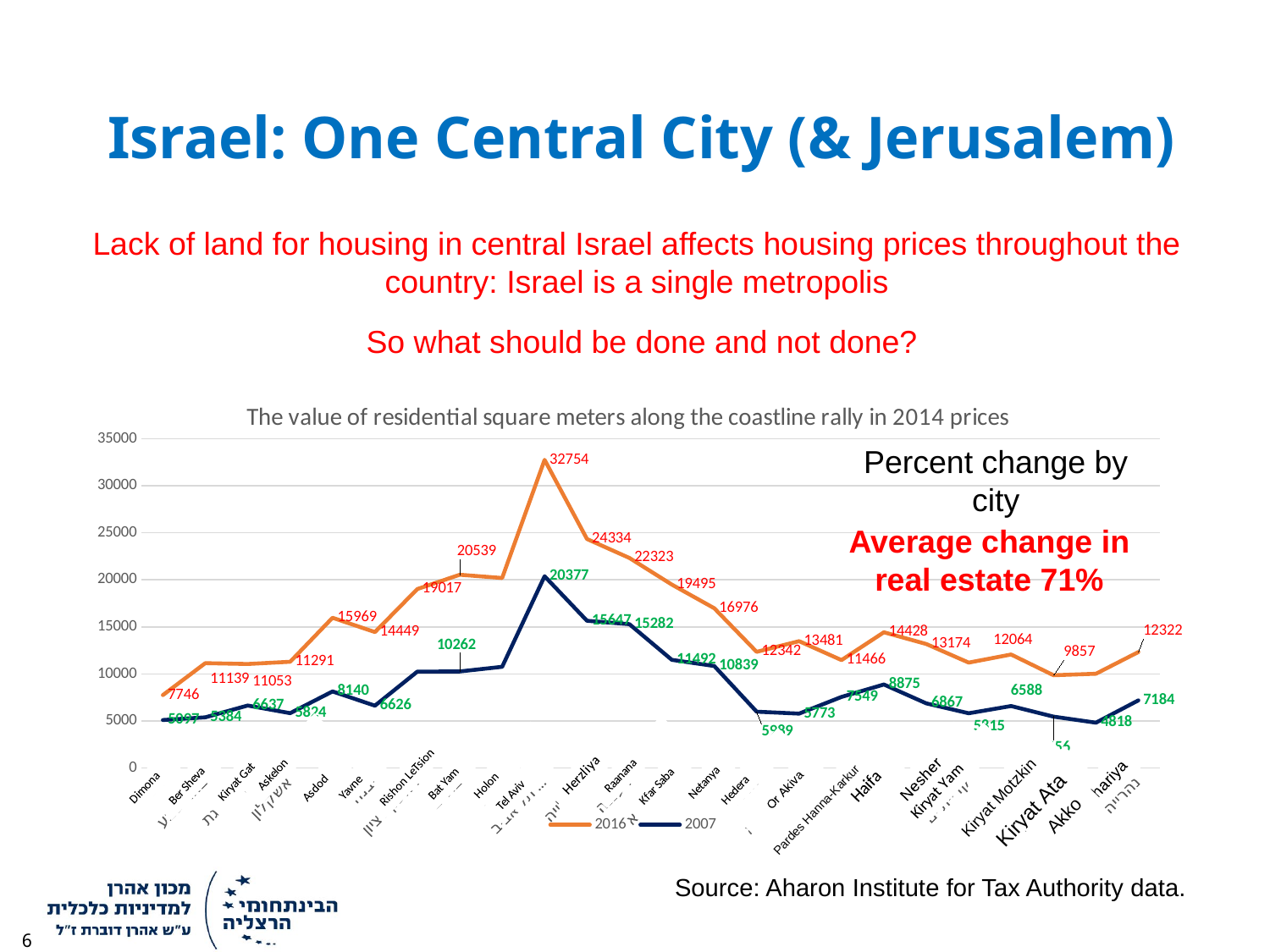
What kind of chart is shown on the slide? line chart Which two years are shown as series in the chart legend? 2016 and 2007 What is the title of the chart? The value of residential square meters along the coastline rally in 2014 prices How many series does the chart's legend list? 2 Which series has the larger value for Herzliya, 2016 or 2007? 2016 What is the 2016 value for Tel Aviv? 32754 What is the 2007 value for Tel Aviv? 20377 What is the difference between the 2016 and 2007 values for Tel Aviv? 12377 What is the 2016 value for Dimona? 7746 Is the 2016 value for Tel Aviv greater or less than 30000? greater Which city has the lowest 2016 value? Dimona Which city has the highest 2016 value? Tel Aviv